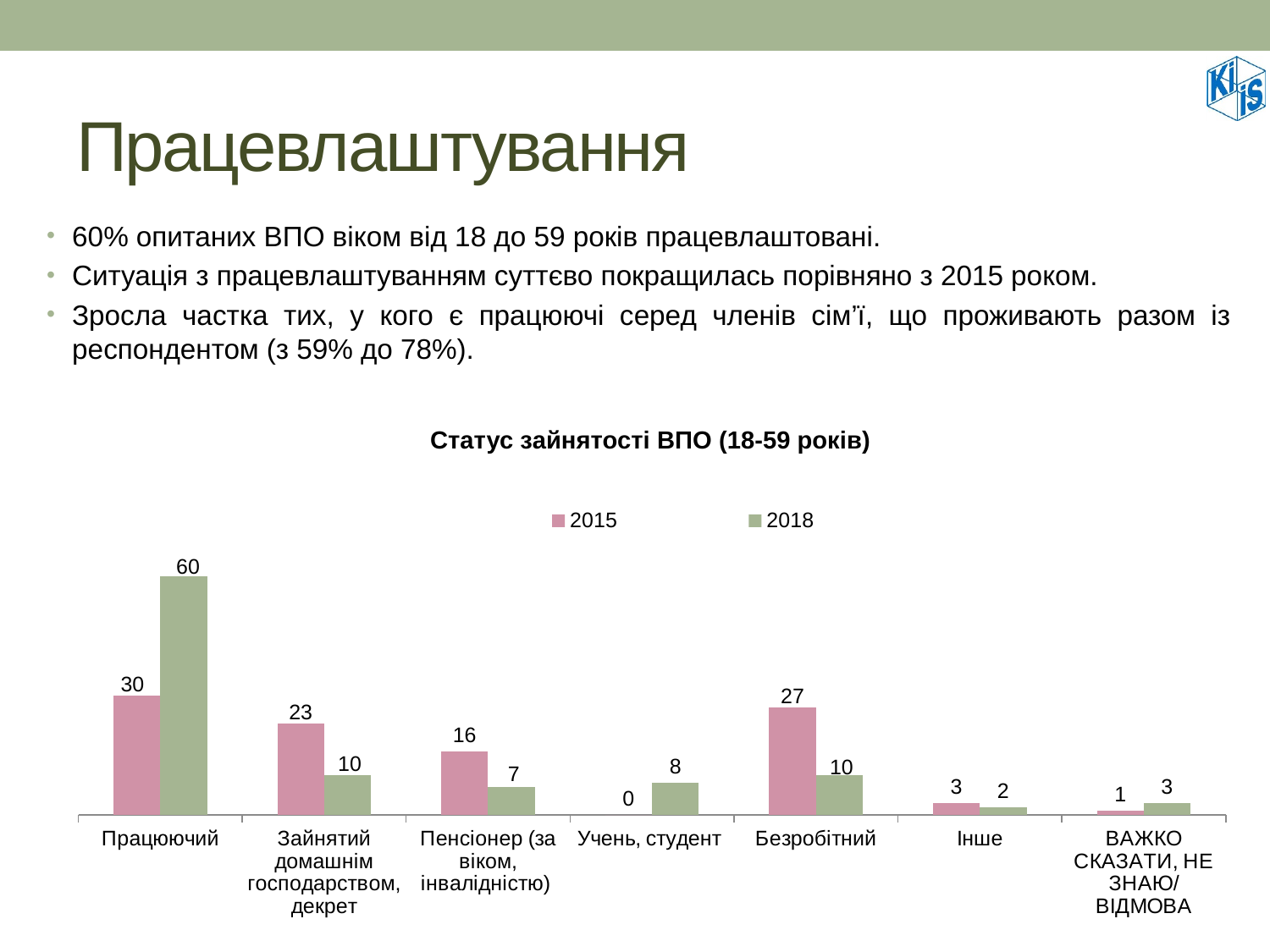
What is the value for Безробітний in 2015? 27 How many series does the legend list? 2 Which category has the highest value in the 2018 series? Працюючий What is the value for Учень, студент in 2015? 0 What is the difference between the 2015 and 2018 values for Безробітний? 17 What kind of chart is shown on the slide? Bar chart What is the value for Працюючий in 2018? 60 What is the difference between the 2018 and 2015 values for Працюючий? 30 What is the title of the chart? Статус зайнятості ВПО (18-59 років) How many categories are shown on the x axis? 7 Which is larger for Зайнятий домашнім господарством, декрет: the 2015 value or the 2018 value? 2015 Which category has the lowest value in the 2015 series? Учень, студент